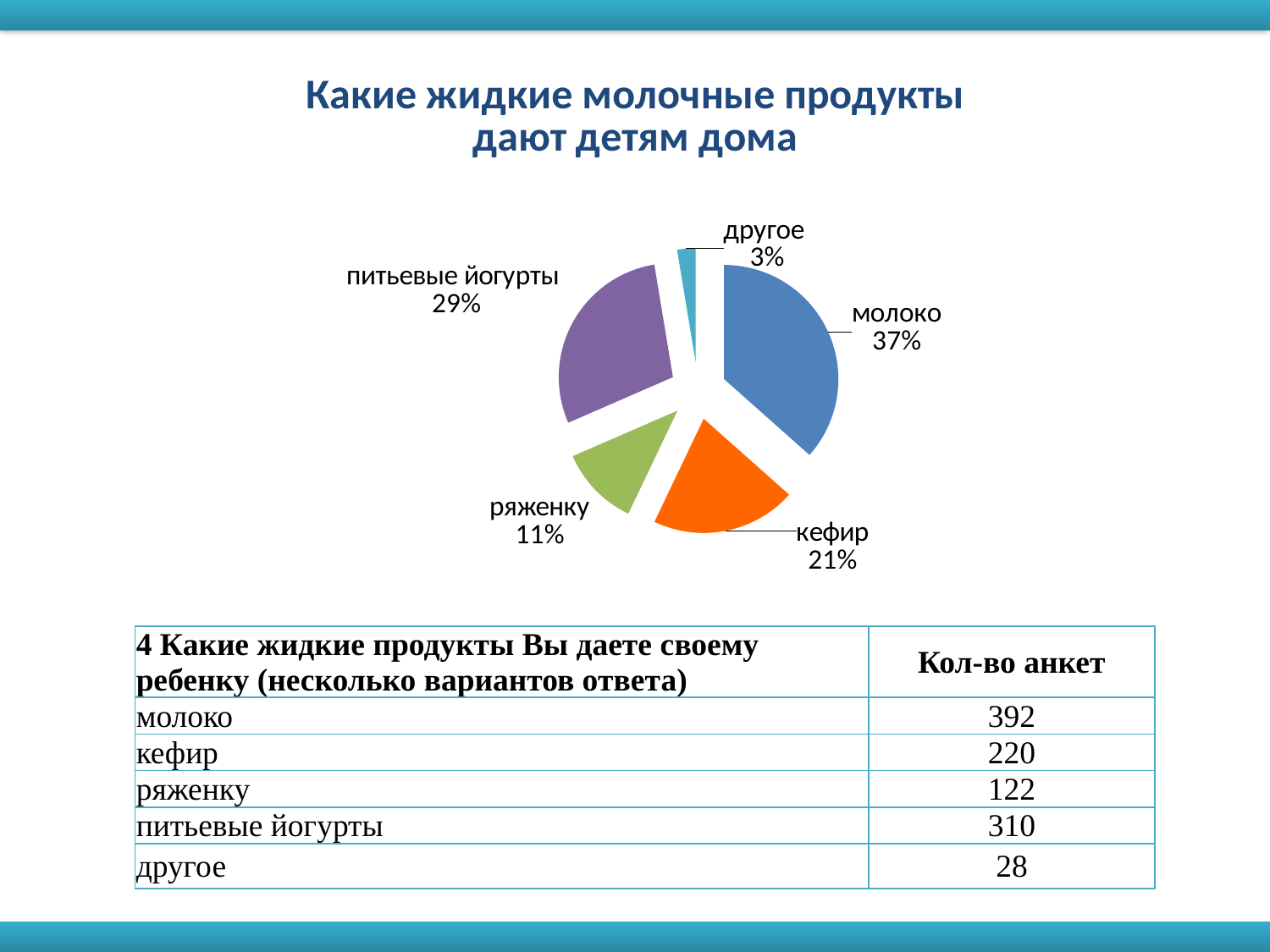
What type of chart is shown on the slide? pie chart Which slice is larger, питьевые йогурты or ряженку? питьевые йогурты What is the difference in percentage points between the молоко slice and the кефир slice? 16% What colour is the slice for кефир? orange What share of the pie does молоко have? 37% What share of the pie does питьевые йогурты have? 29% Which category has the largest slice of the pie? молоко Which category has the smallest slice of the pie? другое What share of the pie does другое have? 3% How many slices does the pie chart have? 5